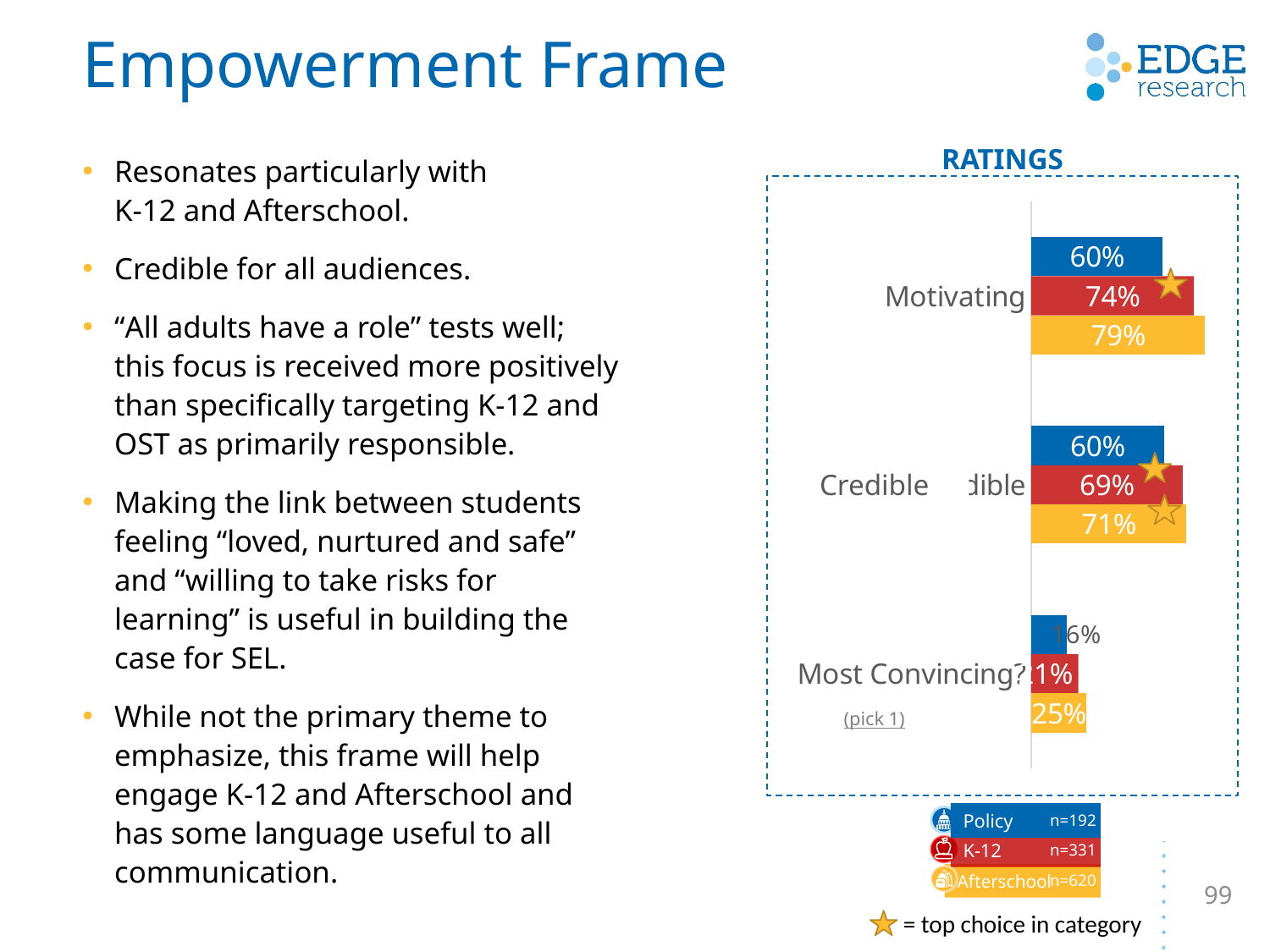
How many categories are shown on the chart? 3 Which is larger, the K-12 value for Motivating or the K-12 value for Credible? K-12 value for Motivating What is the sample size (n) for the Afterschool series in the legend? n=620 Which audience has the highest Motivating rating? Afterschool What kind of chart is shown on the slide? Bar chart Which audience has the lowest Credible rating? Policy What is the Policy value for Motivating? 60% What is the K-12 value for Credible? 69% What is the Afterschool value for Motivating? 79% What is the difference between the Afterschool and Policy values for Motivating? 19 percentage points How many series does the legend list? 3 What is the Afterschool value for Most Convincing? 25%